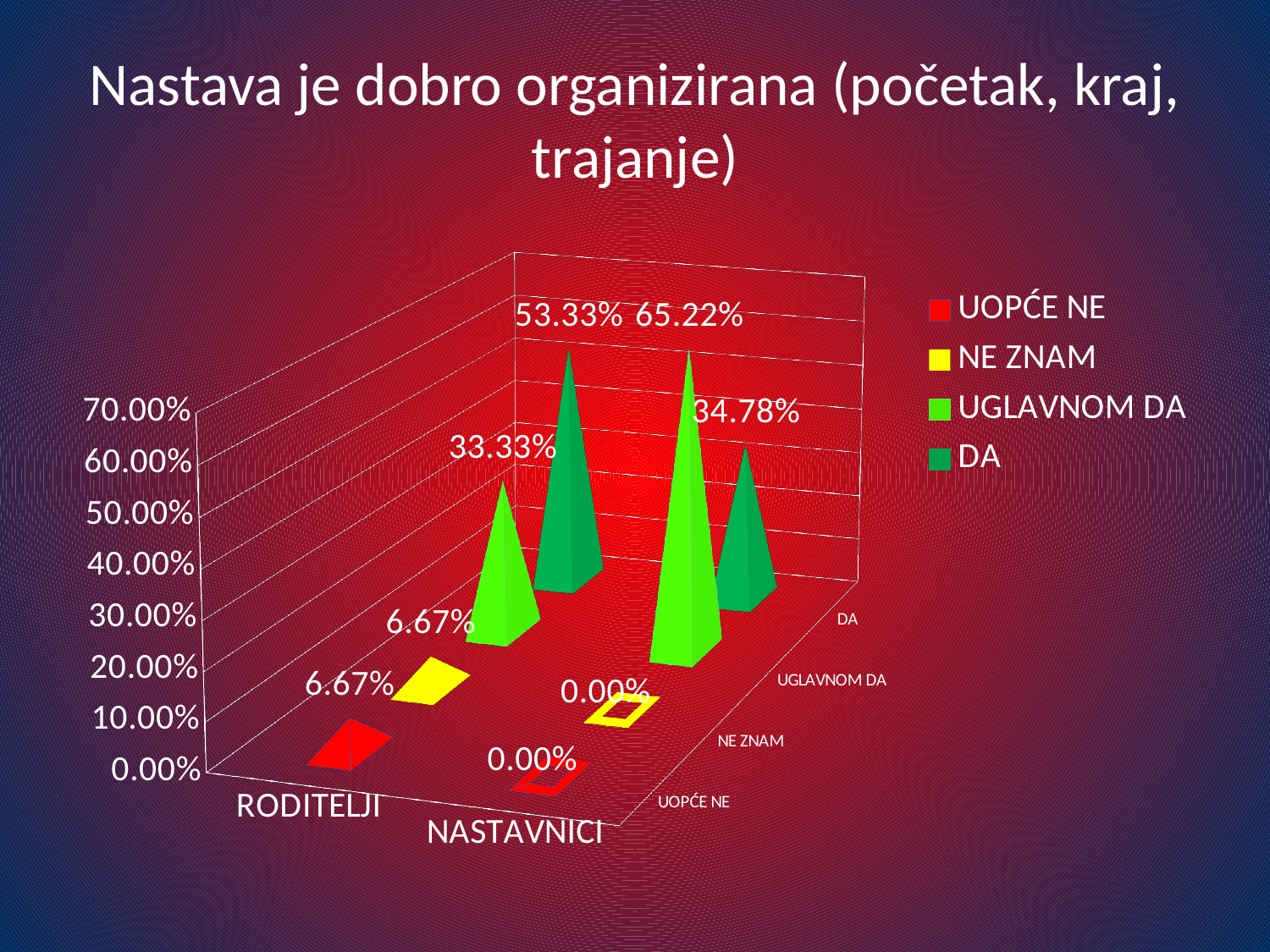
What is the difference between the DA values for RODITELJI and NASTAVNICI? 18.55% What is the title of the chart? Nastava je dobro organizirana (početak, kraj, trajanje) What is the value for RODITELJI in the UGLAVNOM DA series? 33.33% What is the value for RODITELJI in the DA series? 53.33% Which is larger: the UGLAVNOM DA value for RODITELJI or for NASTAVNICI? NASTAVNICI What is the value for NASTAVNICI in the UGLAVNOM DA series? 65.22% How many series does the legend list? 4 What is the value for NASTAVNICI in the DA series? 34.78% Which series has the highest value for NASTAVNICI? UGLAVNOM DA Which series has the highest value for RODITELJI? DA What is the value for RODITELJI in the NE ZNAM series? 6.67% What is the value for NASTAVNICI in the UOPĆE NE series? 0.00%